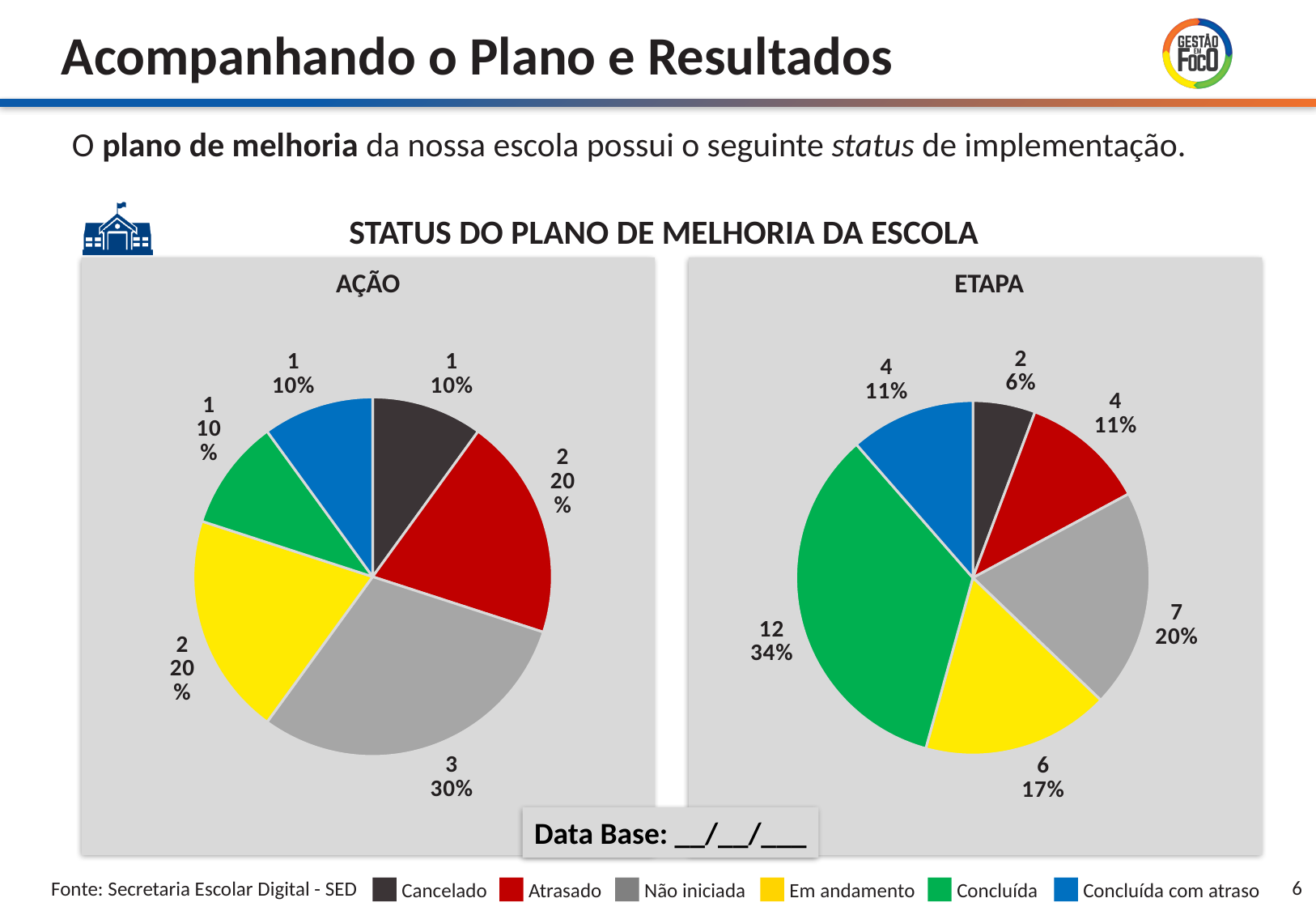
In the ETAPA chart, what percentage share does Concluída have? 34% What type of chart is the AÇÃO chart? pie chart In the AÇÃO chart, which status has the largest slice? Não iniciada In the ETAPA chart, what is the difference between the number of Concluída stages and the number of Em andamento stages? 6 In the ETAPA chart, which is larger: the Atrasado slice or the Não iniciada slice? Não iniciada What colour represents Em andamento in the charts? yellow How many statuses does the legend list? 6 In the ETAPA chart, how many stages are Não iniciada? 7 In the ETAPA chart, which status has the largest slice? Concluída In the AÇÃO chart, how many actions are Atrasado? 2 In the AÇÃO chart, what percentage share does Não iniciada have? 30% In the ETAPA chart, which status has the smallest slice? Cancelado